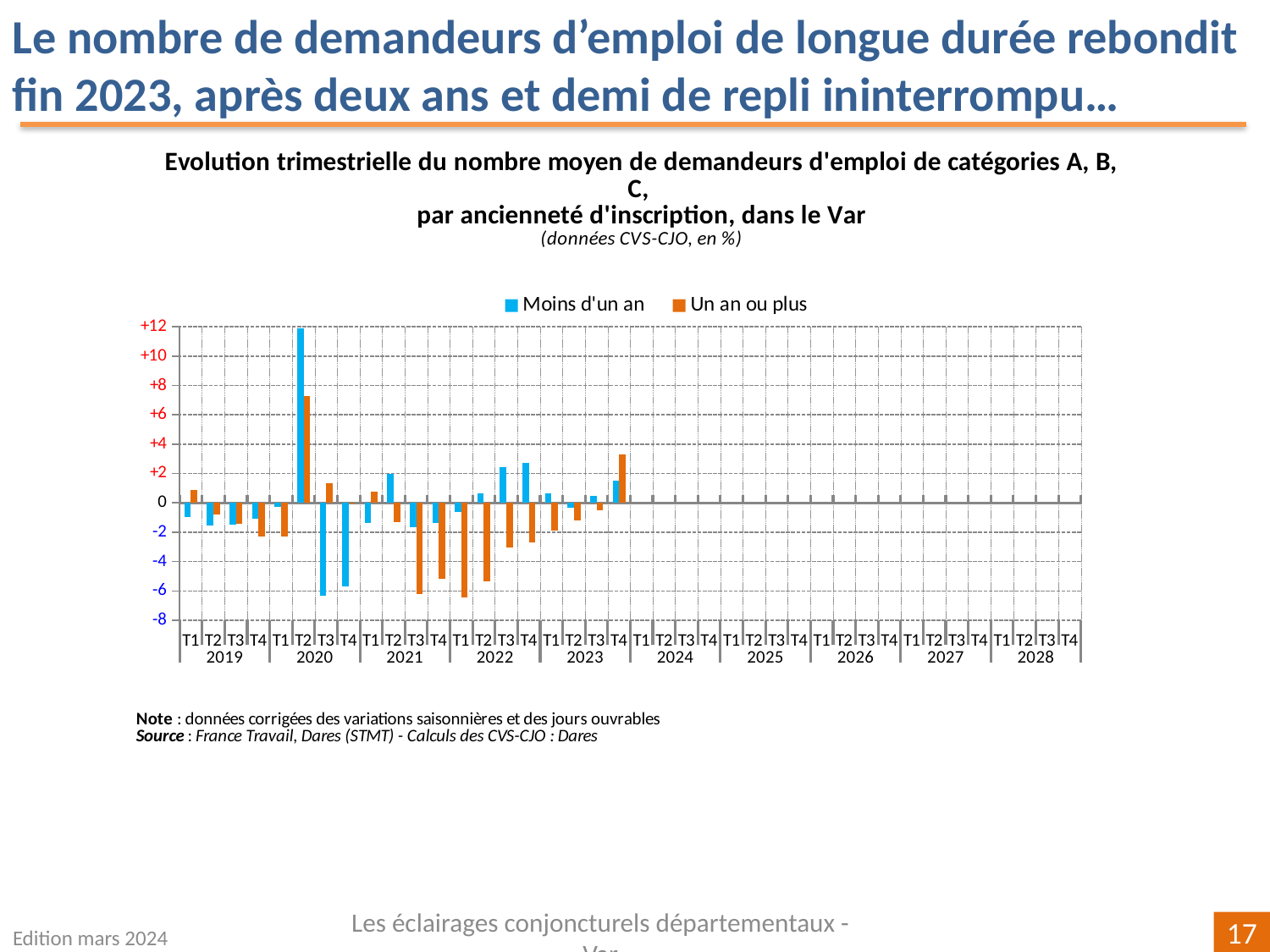
What kind of chart is shown on the slide? Bar chart Is the value for 'Moins d'un an' in T3 2020 greater or less than -4? less Is the value for 'Moins d'un an' in T2 2020 greater or less than +10? greater What are the two series named in the legend? Moins d'un an; Un an ou plus Is the value for 'Un an ou plus' in T4 2023 greater or less than +2? greater In T2 2020, which series has the larger value, 'Moins d'un an' or 'Un an ou plus'? Moins d'un an In which quarter is the value for 'Moins d'un an' highest? T2 2020 How many series does the legend list? 2 In which quarter is the value for 'Un an ou plus' highest? T2 2020 In T4 2023, which series has the larger value, 'Moins d'un an' or 'Un an ou plus'? Un an ou plus